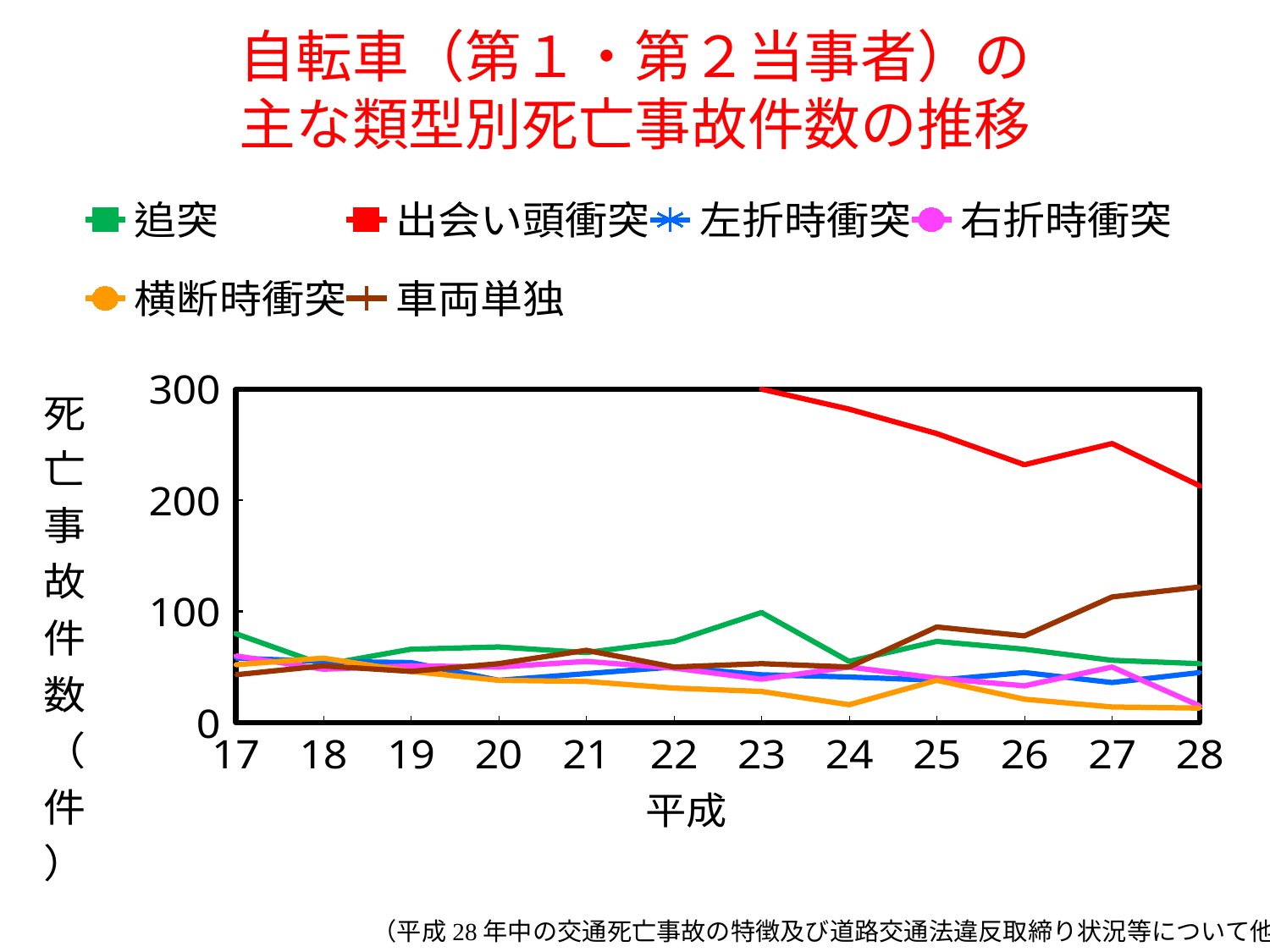
In 平成28, which is larger: 車両単独 or 追突? 車両単独 For 追突, which year has the larger value: 平成23 or 平成24? 平成23 What is the label of the x axis? 平成 Which series has the highest value in 平成28? 出会い頭衝突 How many years (平成) are plotted along the x axis? 12 Does the 出会い頭衝突 series rise or fall from 平成23 to 平成28? fall Is the value for 車両単独 in 平成28 greater or less than 100? greater How many series does the legend list? 6 Is the value for 横断時衝突 in 平成28 greater or less than 100? less What kind of chart is shown on the slide? line chart Is the value for 出会い頭衝突 in 平成28 greater or less than 200? greater Does the 車両単独 series rise or fall from 平成24 to 平成28? rise